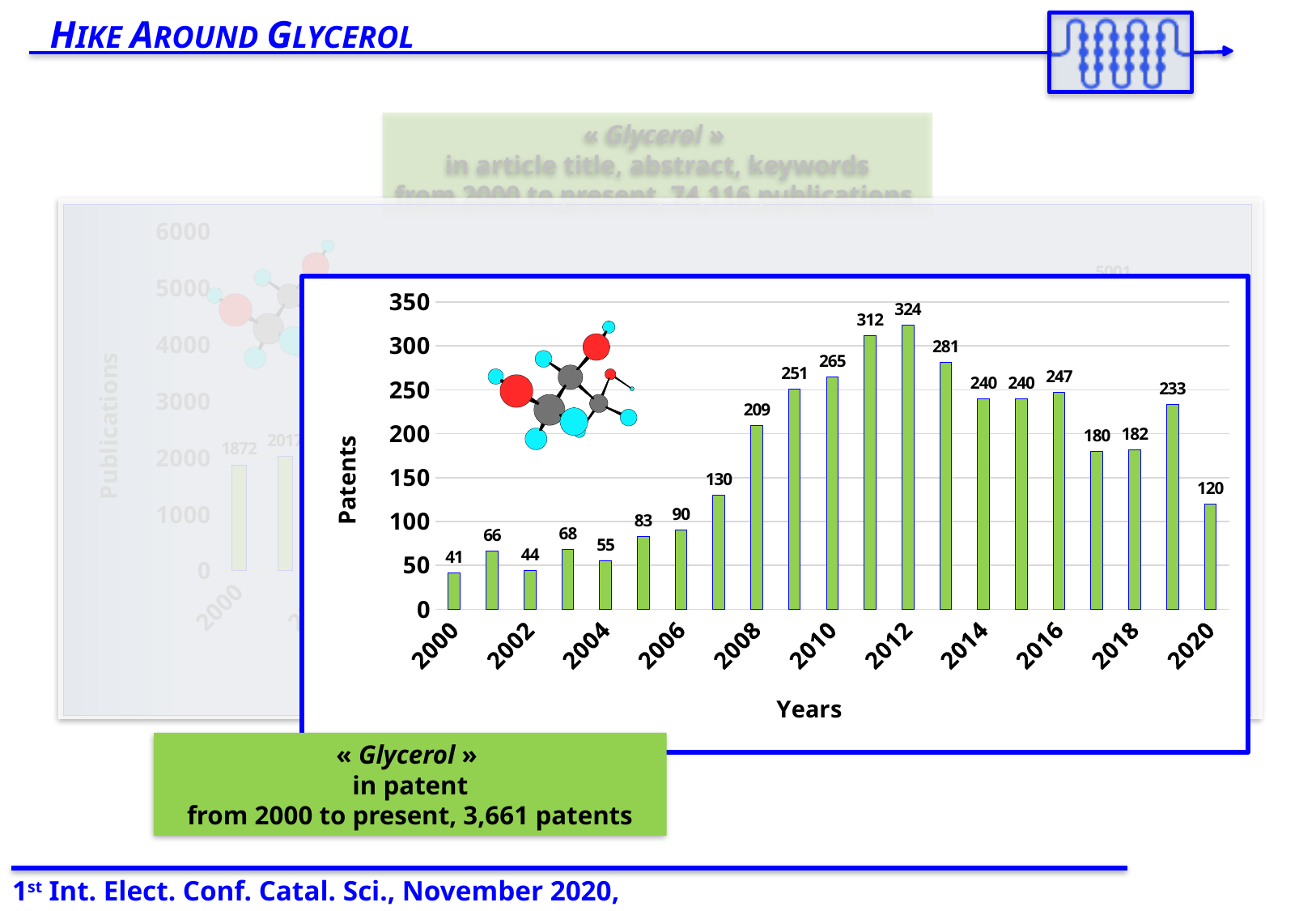
In the patents chart, what is the value for 2020? 120 In the patents chart, what is the difference between the values for 2012 and 2010? 59 In the patents chart, how many bars are plotted? 21 In the patents chart, what is the value for 2014? 240 What kind of chart is the patents chart? bar chart In the patents chart, is the value for 2016 greater or less than 200? greater In the patents chart, do the values rise or fall from 2000 to 2012? rise In the patents chart, which year has the lowest number of patents? 2000 What is the label of the y axis of the patents chart? Patents In the patents chart, how many patents are shown for 2008? 209 In the patents chart, which year has a larger value, 2018 or 2020? 2018 In the patents chart, which year has the highest number of patents? 2012